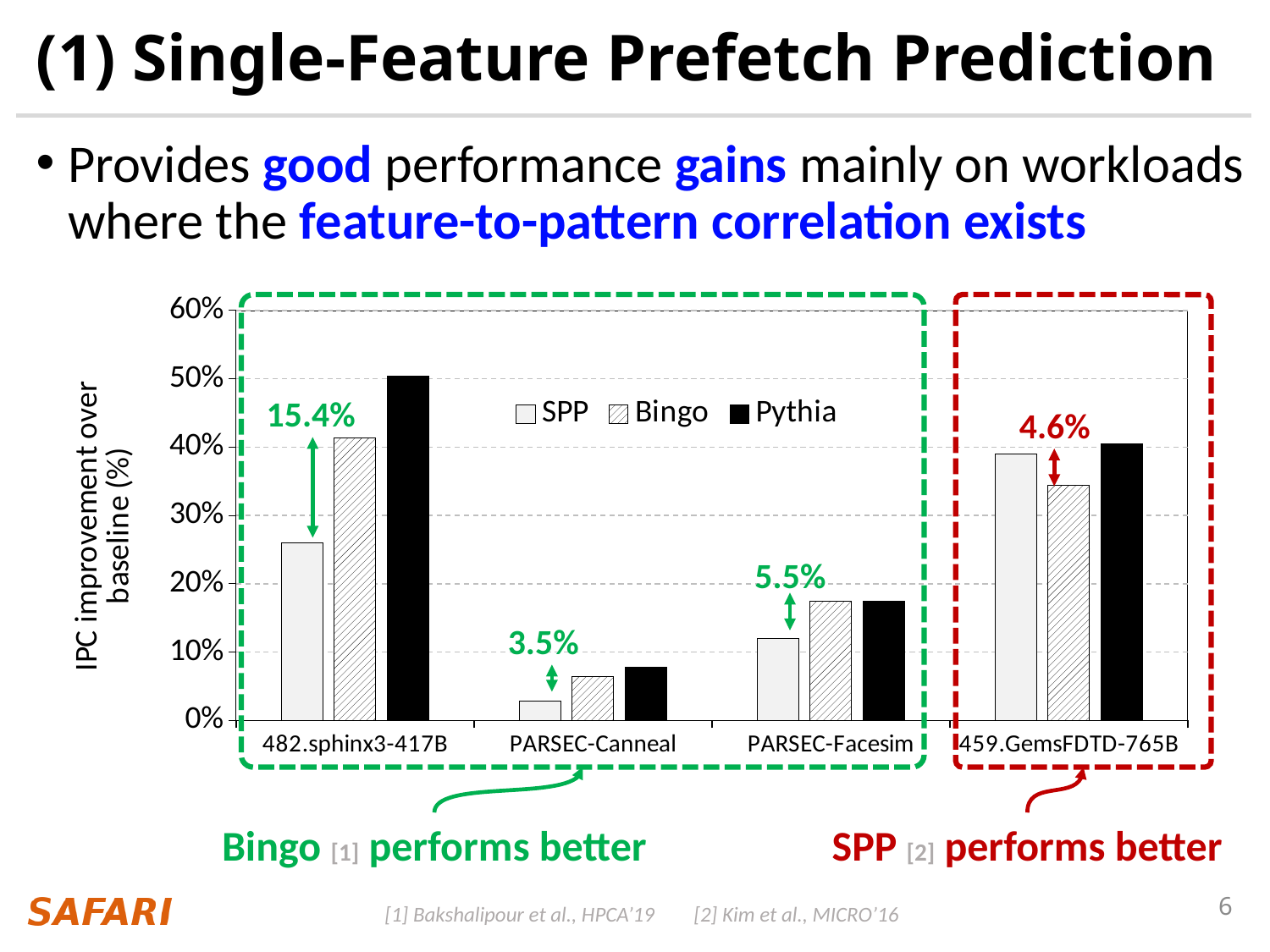
What is the annotated gap between the SPP and Bingo bars for 459.GemsFDTD-765B? 4.6% What are the three series named in the chart's legend? SPP, Bingo, Pythia How many workload categories are shown on the x axis of the chart? 4 What kind of chart is shown on the slide? bar chart What is the title of the chart's y axis? IPC improvement over baseline (%) How many series does the chart's legend list? 3 Is the SPP value for PARSEC-Canneal greater or less than 10%? less What is the annotated gap between the SPP and Bingo bars for PARSEC-Canneal? 3.5% What is the annotated gap between the SPP and Bingo bars for 482.sphinx3-417B? 15.4% For 459.GemsFDTD-765B, which is larger: the SPP bar or the Bingo bar? SPP Which series has the highest bar for 482.sphinx3-417B? Pythia Is the Pythia value for 482.sphinx3-417B greater or less than 40%? greater